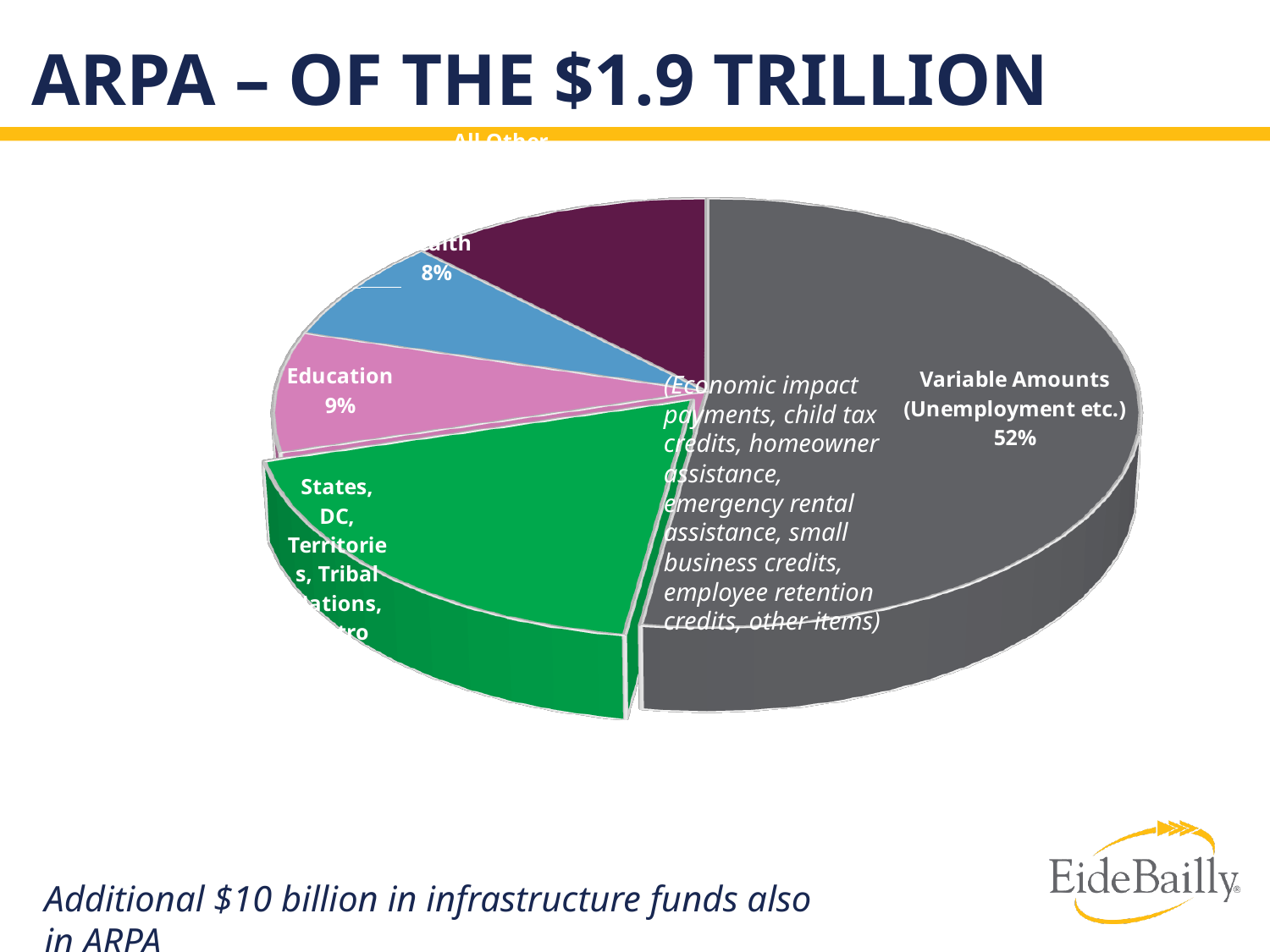
What is the difference in percentage points between the Variable Amounts (Unemployment etc.) slice and the Education slice? 43 Which slice of the pie is the largest? Variable Amounts (Unemployment etc.) What kind of chart is shown on the slide? pie chart What percentage is printed on the blue slice of the pie? 8% What percentage of the $1.9 trillion goes to Variable Amounts (Unemployment etc.)? 52% How many slices does the pie chart have? 5 What colour is the Variable Amounts (Unemployment etc.) slice? gray What is the title of the slide containing the pie chart? ARPA – OF THE $1.9 TRILLION What percentage of the pie is labelled Education? 9% Which is larger, the Education slice or the Variable Amounts (Unemployment etc.) slice? Variable Amounts (Unemployment etc.) Which is larger, the green States, DC, Territories, Tribal Nations slice or the pink Education slice? States, DC, Territories, Tribal Nations What share of the pie does the Variable Amounts (Unemployment etc.) slice represent? 52%